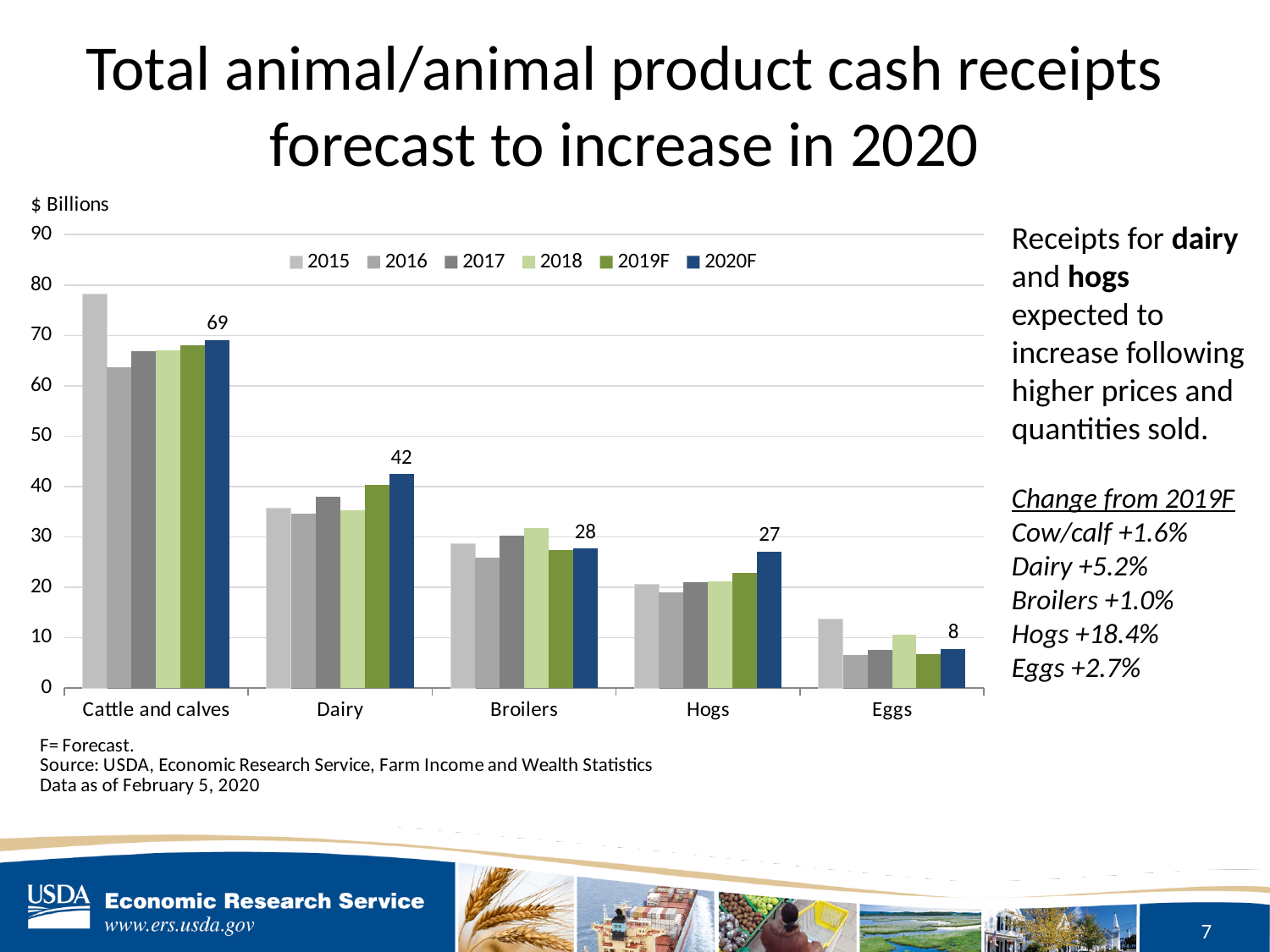
Is the 2015 value for Eggs greater or less than 10? greater Which category has the lowest 2020F value? Eggs What is the 2020F value for Cattle and calves? 69 What is the 2020F value for Eggs? 8 What unit is shown on the y axis? $ Billions How many categories are shown on the x axis? 5 Which has the larger 2020F value, Broilers or Hogs? Broilers Is the 2015 value for Cattle and calves greater or less than 70? greater What is the 2020F value for Dairy? 42 What is the difference between the 2020F values for Cattle and calves and Dairy? 27 How many series does the legend list? 6 Which category has the highest 2020F value? Cattle and calves